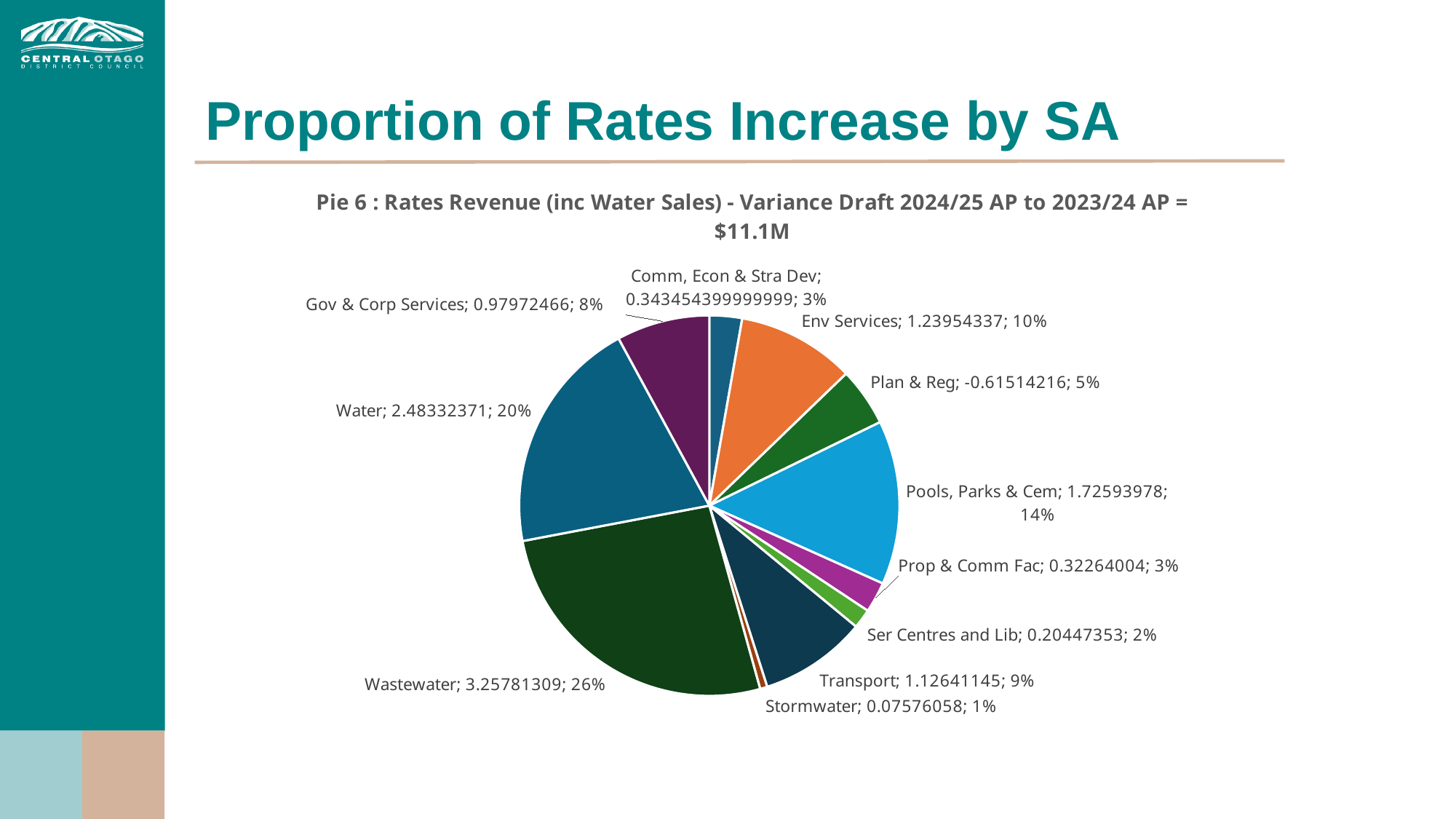
What value is shown for Pools, Parks & Cem? 1.72593978 What kind of chart is shown on the slide? pie chart What percentage share does Water have? 20% Which has a larger share, Env Services or Gov & Corp Services? Env Services Which category has the largest share of the pie? Wastewater What value is shown for Plan & Reg? -0.61514216 What value is shown for Ser Centres and Lib? 0.20447353 How many slices does the pie chart have? 11 What percentage share does Transport have? 9% What is the difference in percentage share between Wastewater and Water? 6% Which category has the smallest share of the pie? Stormwater What total variance amount is stated in the chart title? $11.1M